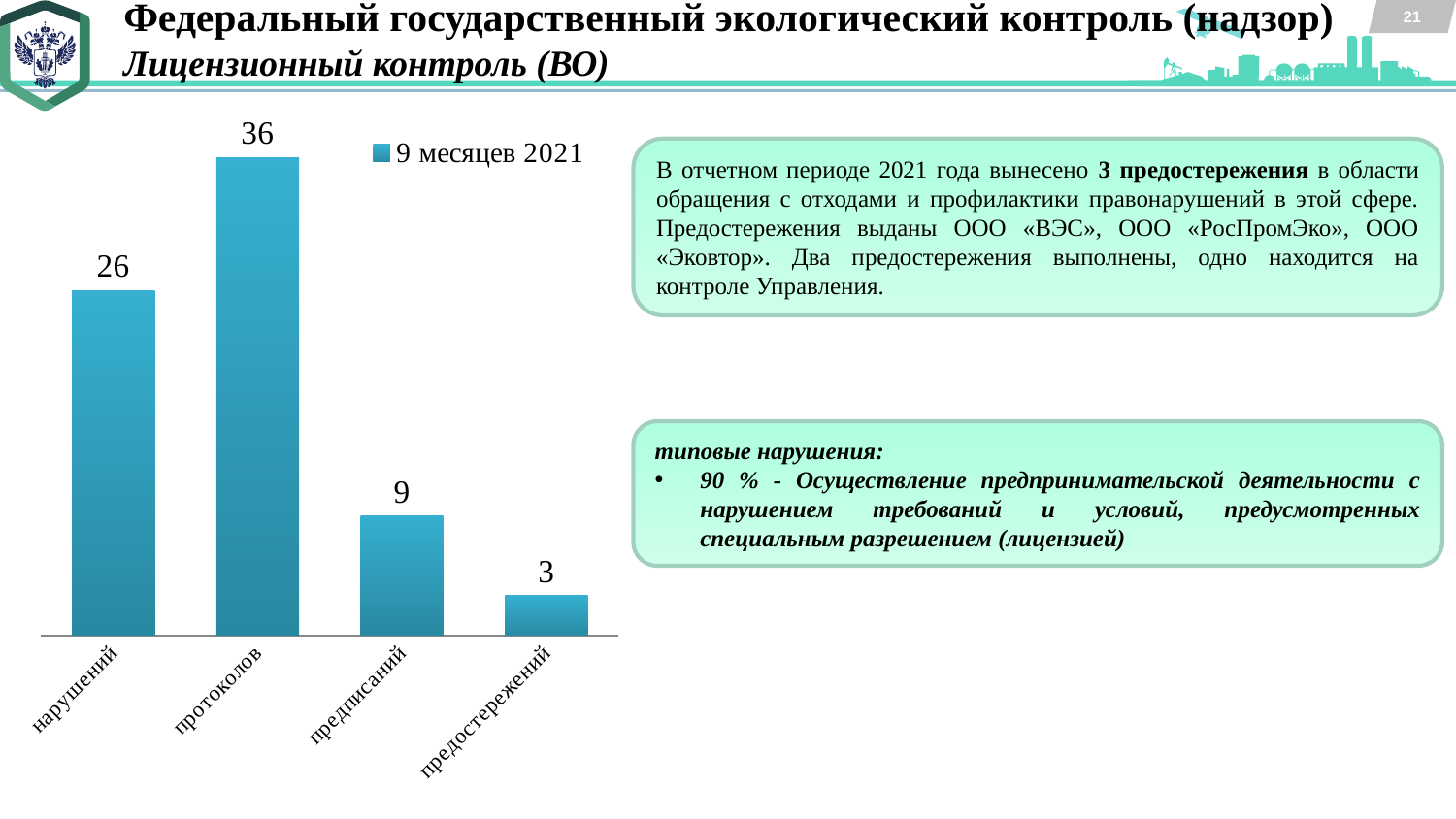
Which category has the lowest value? предостережений What is the value for предостережений? 3 How many categories are shown on the chart? 4 What is the value for протоколов? 36 Which is larger, the value for предписаний or the value for предостережений? предписаний What is the difference between the values for протоколов and нарушений? 10 What kind of chart is shown on the slide? bar chart Which category has the highest value? протоколов What is the legend entry for the series shown on the chart? 9 месяцев 2021 What is the value for нарушений? 26 What is the value for предписаний? 9 How many series does the legend list? 1